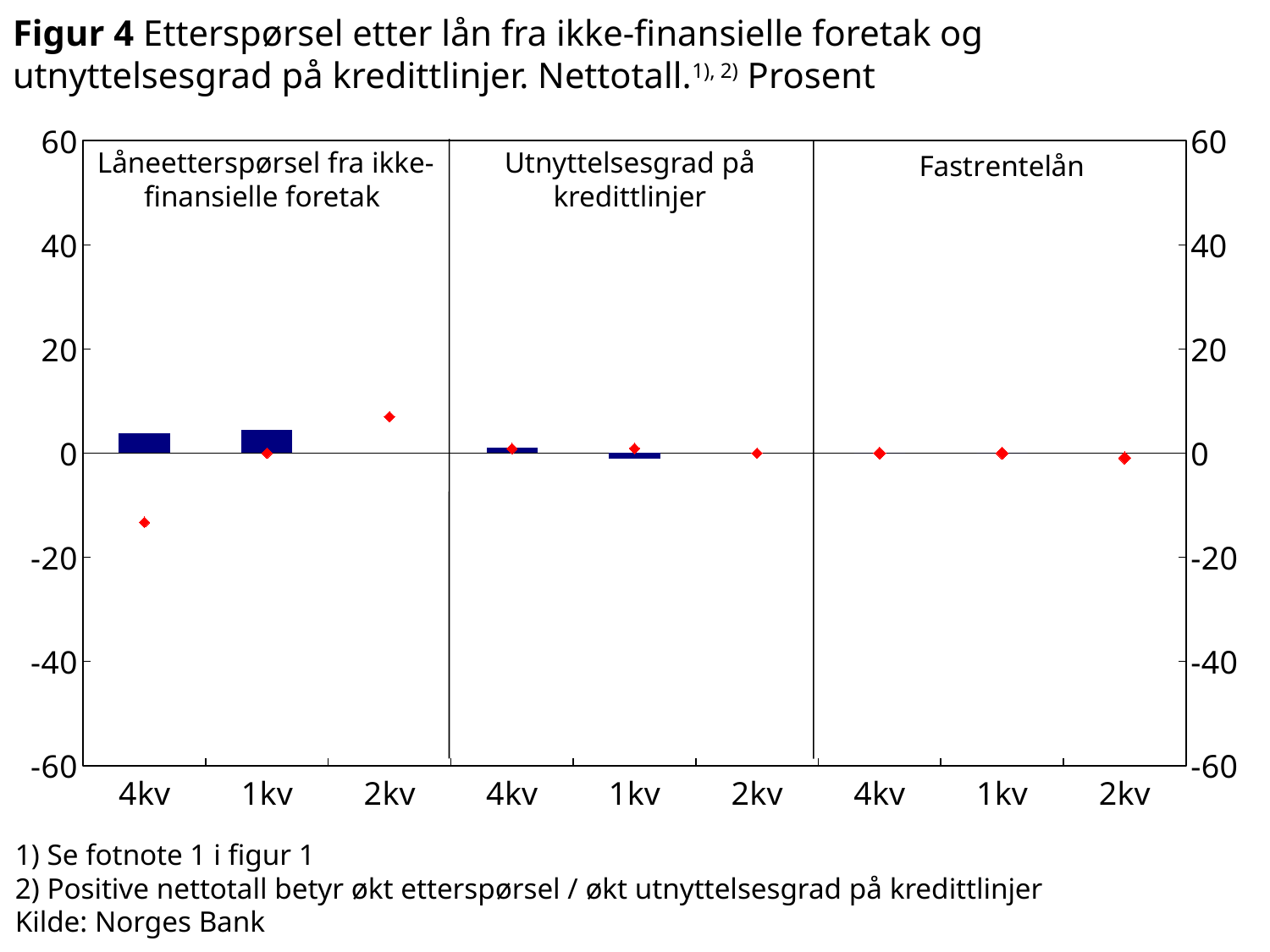
In the panel 'Låneetterspørsel fra ikke-finansielle foretak', is the bar for 1kv greater or less than 20? less In the panel 'Låneetterspørsel fra ikke-finansielle foretak', which quarter has the lowest red diamond? 4kv In the panel 'Låneetterspørsel fra ikke-finansielle foretak', is the red diamond for 2kv greater or less than 0? greater In the panel 'Låneetterspørsel fra ikke-finansielle foretak', is the red diamond for 4kv greater or less than 0? less In the panel 'Låneetterspørsel fra ikke-finansielle foretak', which quarter has the highest red diamond? 2kv How many quarters are shown on the x axis within each panel? 3 In the panel 'Låneetterspørsel fra ikke-finansielle foretak', which is larger: the red diamond for 4kv or the red diamond for 2kv? 2kv What is the title of the third panel of the chart? Fastrentelån What source is given for the chart? Norges Bank What kind of chart is shown on the slide? combination bar and line chart (bars with red diamond markers) How many panels (sections) does the chart have? 3